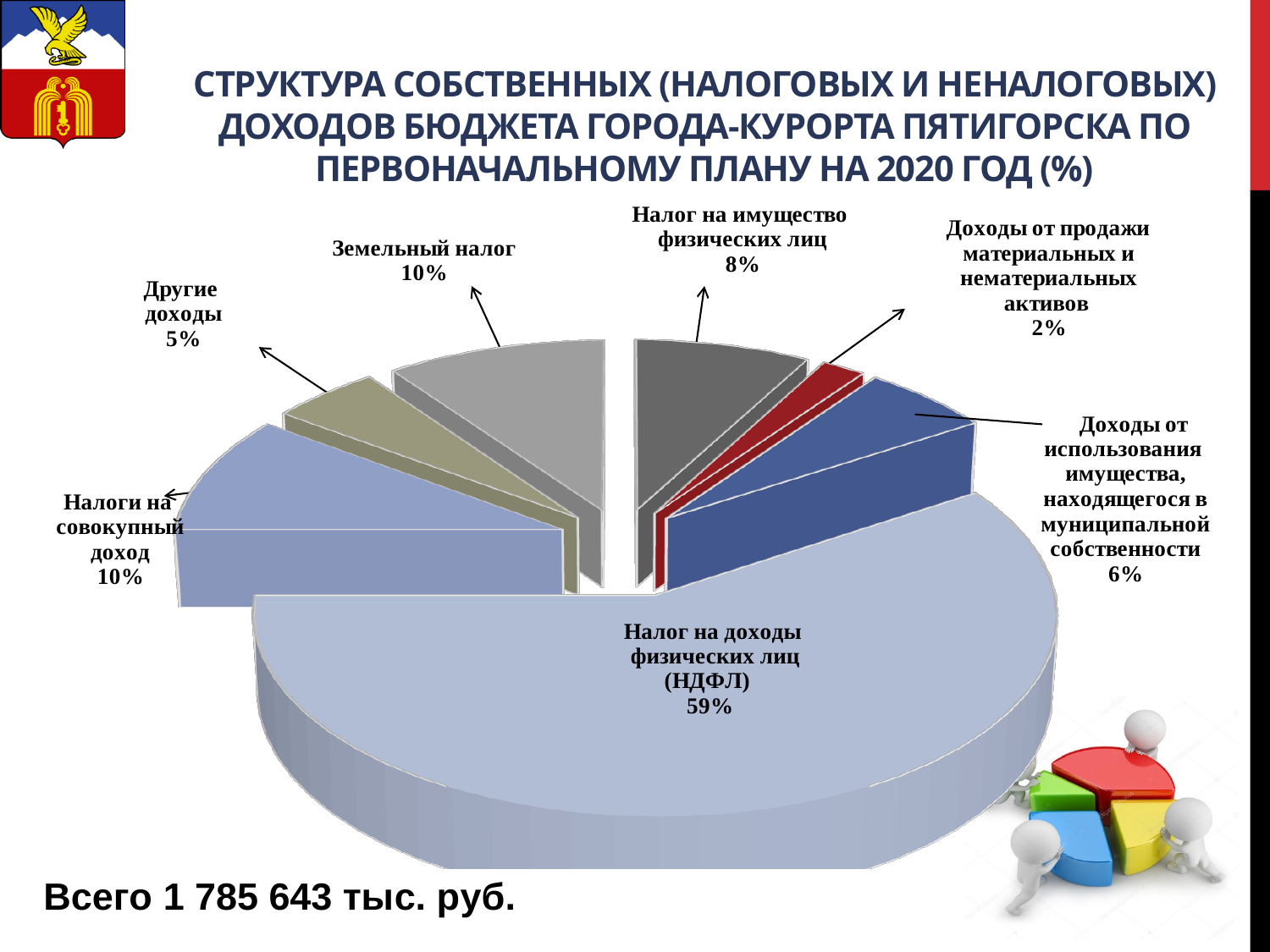
What is the difference in percentage points between Налог на имущество физических лиц and Другие доходы? 3 What share is shown for Доходы от продажи материальных и нематериальных активов? 2% What share of the budget's own revenues comes from Налог на доходы физических лиц (НДФЛ)? 59% What share is shown for Доходы от использования имущества, находящегося в муниципальной собственности? 6% Which is larger: the share for Налоги на совокупный доход or the share for Доходы от использования имущества, находящегося в муниципальной собственности? Налоги на совокупный доход What share is shown for Налог на имущество физических лиц? 8% What kind of chart is shown on the slide? Pie chart How many slices does the pie chart have? 7 Which category has the largest share of the pie? Налог на доходы физических лиц (НДФЛ) Which category has the smallest share of the pie? Доходы от продажи материальных и нематериальных активов What total amount in thousand rubles is stated below the chart? 1 785 643 тыс. руб. What share is shown for Земельный налог? 10%